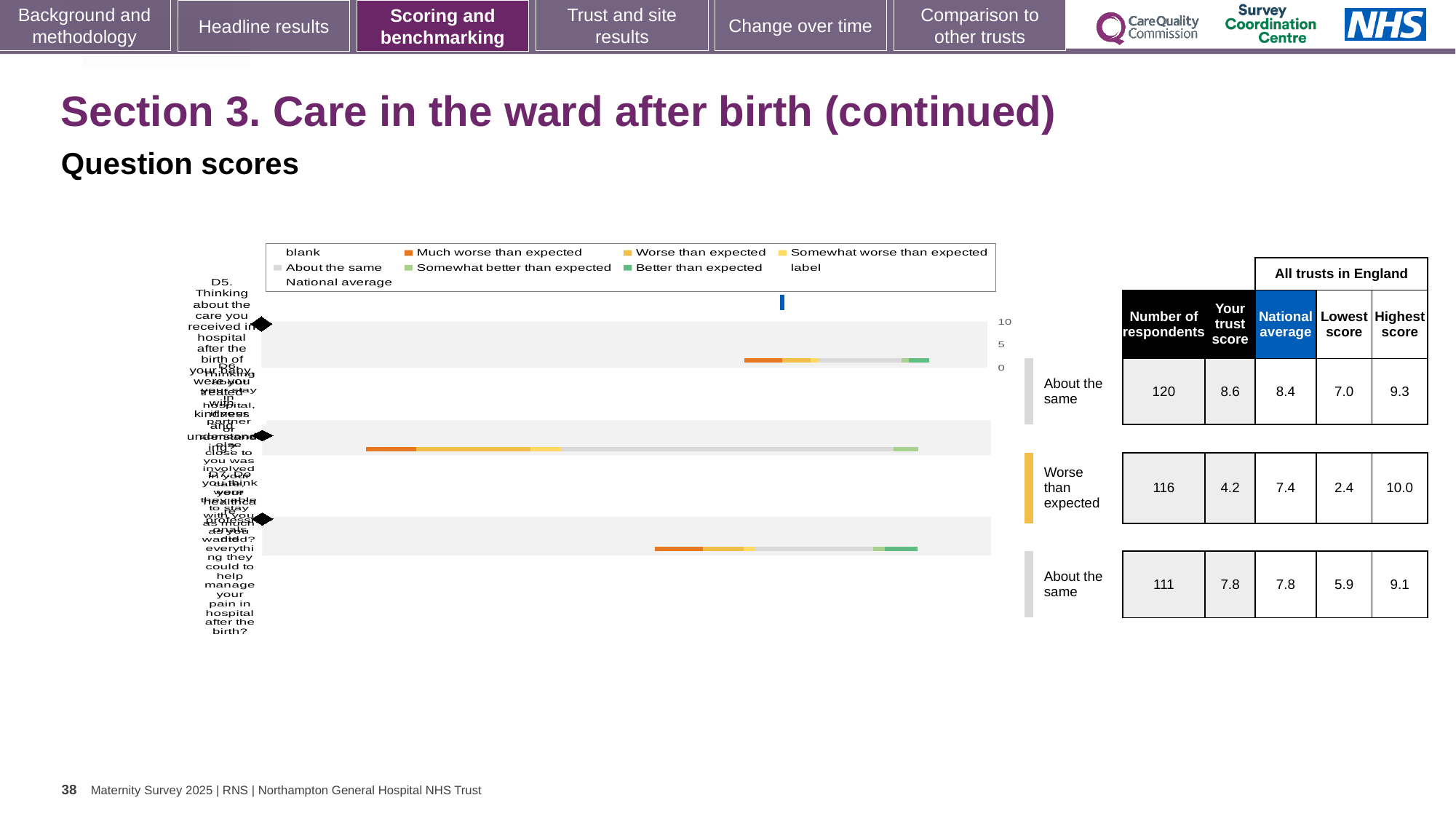
In the table next to the chart, what is the number of respondents for the first row? 120 Is the trust score for the first row (8.6) larger or smaller than its national average (8.4)? larger What benchmark label is shown for the second row of the chart? Worse than expected How many question rows (bars) are plotted in the chart? 3 Which row in the table has the lowest trust score? the second row (4.2) In the table next to the chart, what is the highest score for the first row? 9.3 In the table next to the chart, what is the lowest score for the second row? 2.4 What is the difference between the national average and the trust score for the second row? 3.2 What kind of chart is shown on the slide? bar chart In the table next to the chart, what is the national average for the third row? 7.8 What is the heading above the National average, Lowest score and Highest score columns in the table? All trusts in England In the table next to the chart, what is the trust score for the second row? 4.2